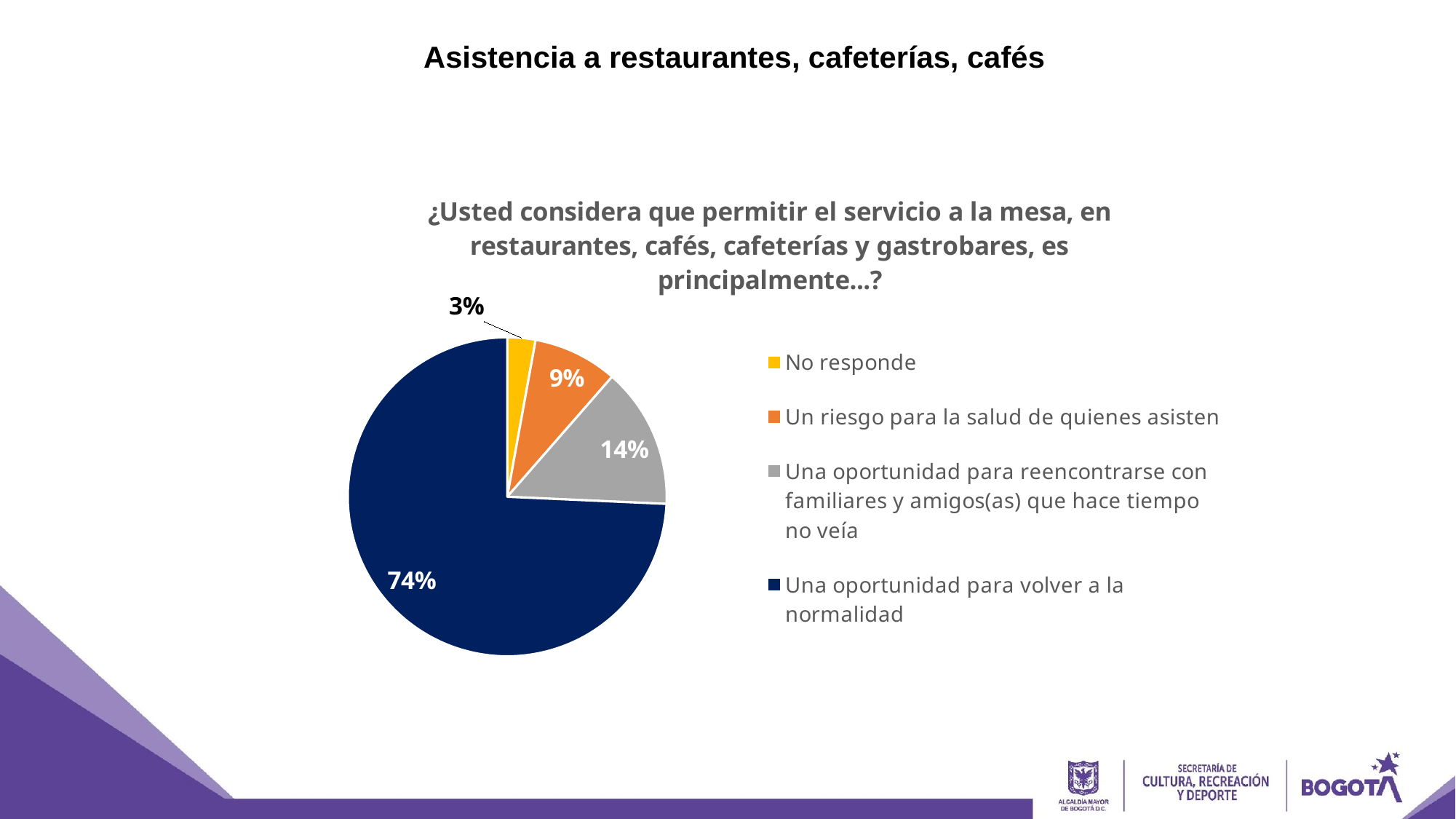
What share of the pie is 'No responde'? 3% What is the difference between the share for 'Una oportunidad para volver a la normalidad' and the share for 'Una oportunidad para reencontrarse con familiares y amigos(as) que hace tiempo no veía'? 60% What share of the pie is 'Un riesgo para la salud de quienes asisten'? 9% What share of the pie is 'Una oportunidad para volver a la normalidad'? 74% What type of chart is shown on the slide? pie chart What is the title of the slide? Asistencia a restaurantes, cafeterías, cafés Which category has the largest slice of the pie? Una oportunidad para volver a la normalidad Which is larger: the share for 'Un riesgo para la salud de quienes asisten' or the share for 'No responde'? Un riesgo para la salud de quienes asisten What colour is the slice for 'Un riesgo para la salud de quienes asisten'? orange How many categories does the pie chart have? 4 Which category has the smallest slice of the pie? No responde